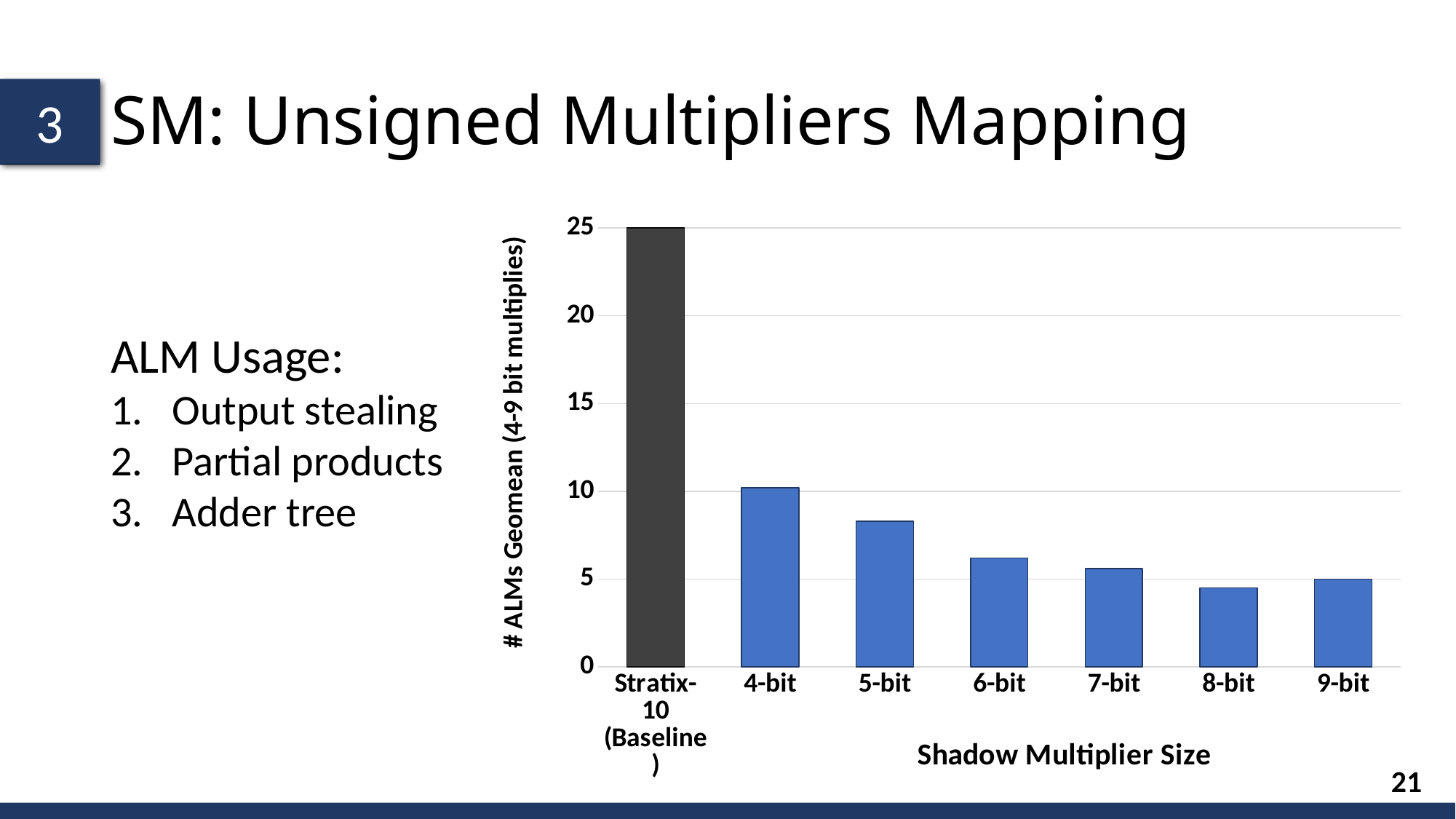
Is the value for 5-bit greater or less than 10? less What kind of chart is shown on the slide? bar chart Which has a higher number of ALMs, 4-bit or 5-bit? 4-bit What is the label of the x axis of the chart? Shadow Multiplier Size How many categories are shown on the x axis of the chart? 7 Which category has the lowest number of ALMs in the chart? 8-bit What is the label of the y axis of the chart? # ALMs Geomean (4-9 bit multiplies) Is the value for 8-bit greater or less than 5? less Is the value for 6-bit greater or less than 5? greater Which has a higher number of ALMs, 7-bit or Stratix-10 (Baseline)? Stratix-10 (Baseline) Which category has the highest number of ALMs in the chart? Stratix-10 (Baseline)